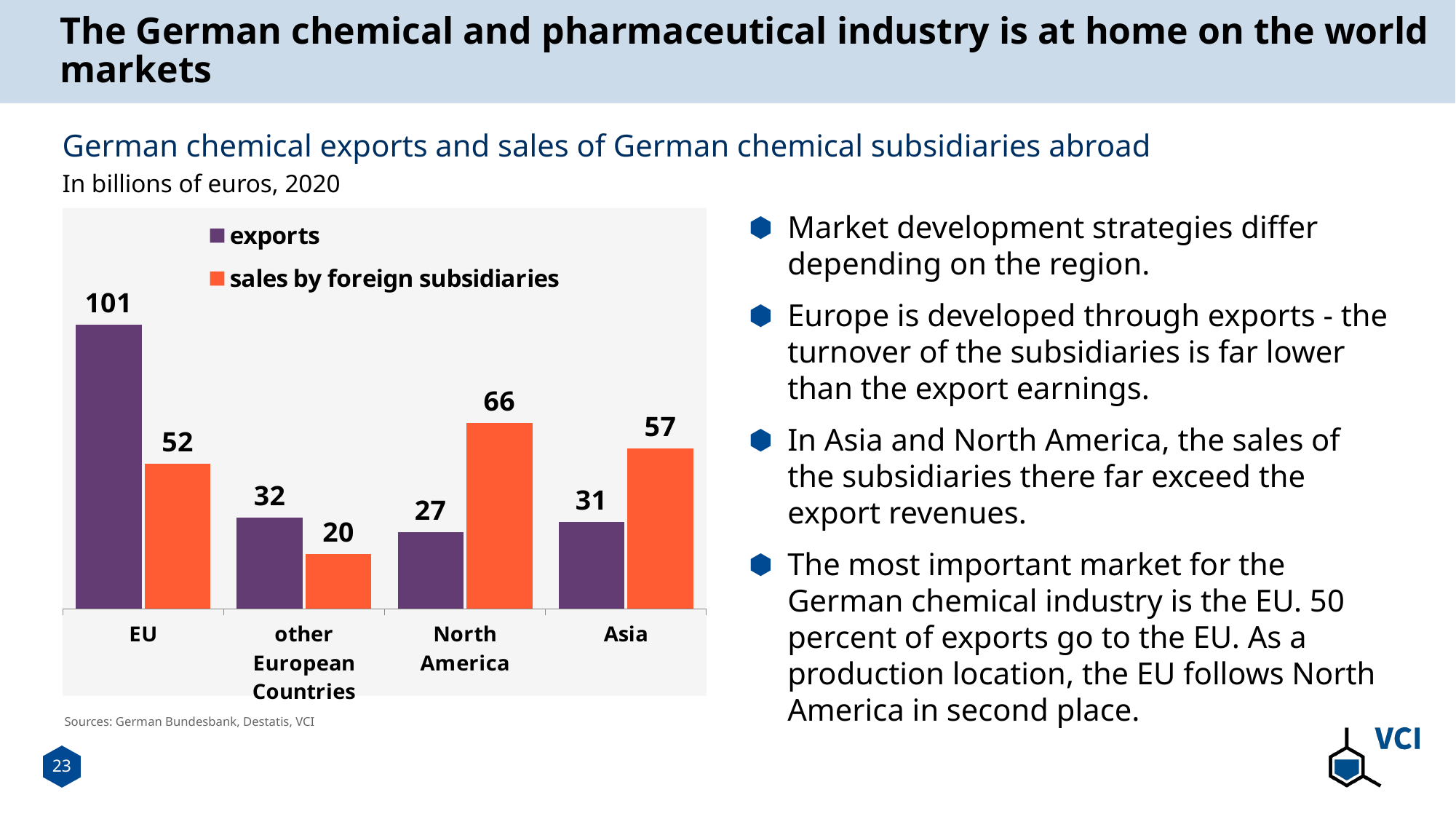
What is the value of exports for Asia? 31 What is the difference between sales by foreign subsidiaries for North America and for Asia? 9 Which region has the lowest sales by foreign subsidiaries value? other European Countries How many series does the legend list? 2 What is the difference between exports and sales by foreign subsidiaries for the EU? 49 What is the value of exports for the EU? 101 What kind of chart is shown on the slide? bar chart How many regions are shown on the x axis of the chart? 4 Which region has the highest exports value? EU What is the value of sales by foreign subsidiaries for North America? 66 What is the value of sales by foreign subsidiaries for other European Countries? 20 Which is larger for Asia: exports or sales by foreign subsidiaries? sales by foreign subsidiaries